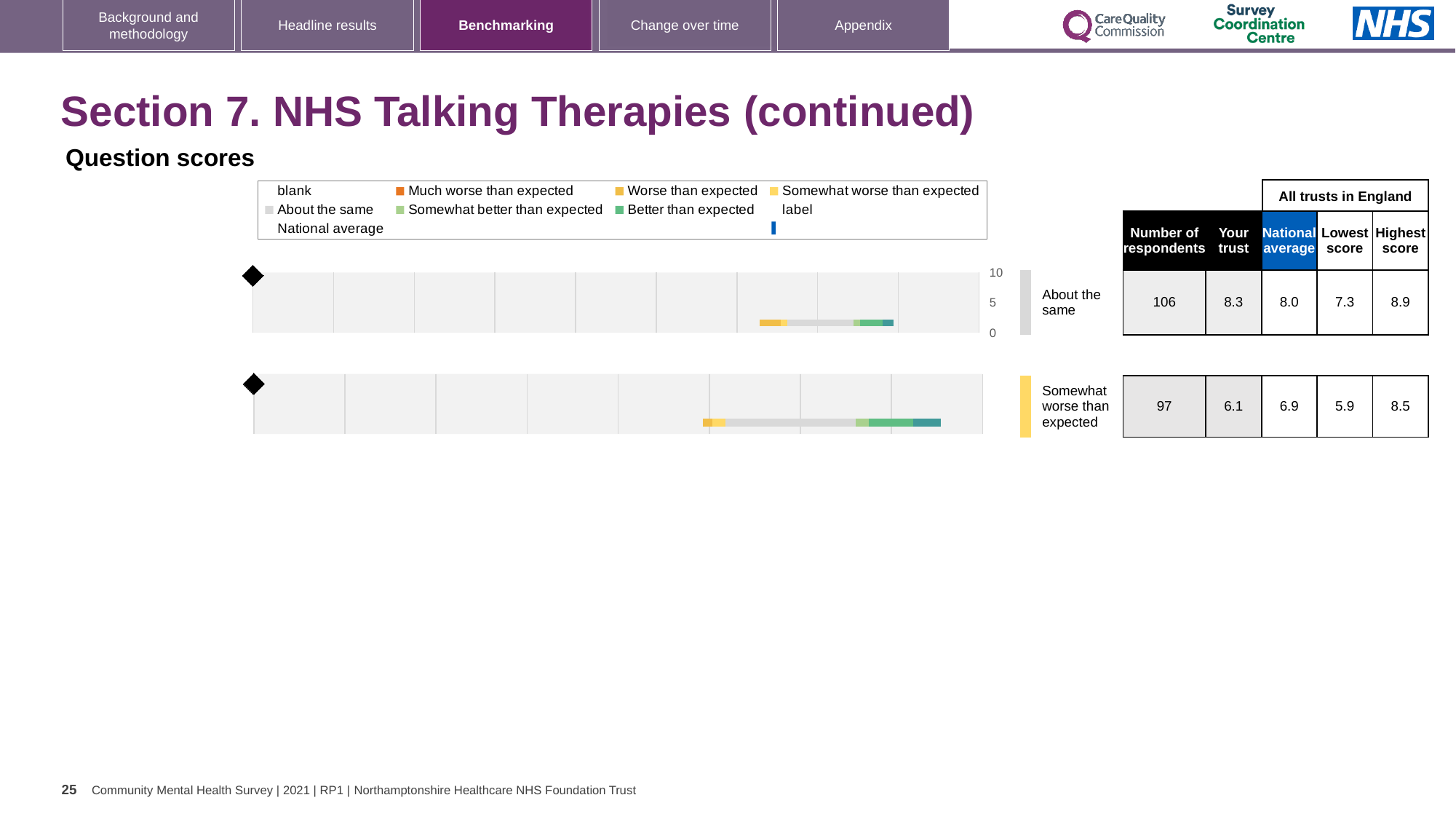
For the top chart (rated 'About the same'), what is the national average score? 8.0 What is the maximum value shown on the score axis of the top chart? 10 For the bottom chart (rated 'Somewhat worse than expected'), which is larger: the 'Your trust' score or the national average? National average What kind of chart is used to show the question scores on this slide? Bar chart For the bottom chart (rated 'Somewhat worse than expected'), what is the lowest score among all trusts in England? 5.9 For the top chart (rated 'About the same'), which is larger: the 'Your trust' score or the national average? Your trust For the bottom chart (rated 'Somewhat worse than expected'), how many respondents are listed? 97 For the top chart (rated 'About the same'), what is the highest score among all trusts in England? 8.9 For the bottom chart (rated 'Somewhat worse than expected'), what is the 'Your trust' score? 6.1 For the top chart (rated 'About the same'), what is the 'Your trust' score shown in the table? 8.3 For the bottom chart (rated 'Somewhat worse than expected'), what is the difference between the national average and the 'Your trust' score? 0.8 For the top chart (rated 'About the same'), what is the difference between the highest and lowest scores among all trusts in England? 1.6